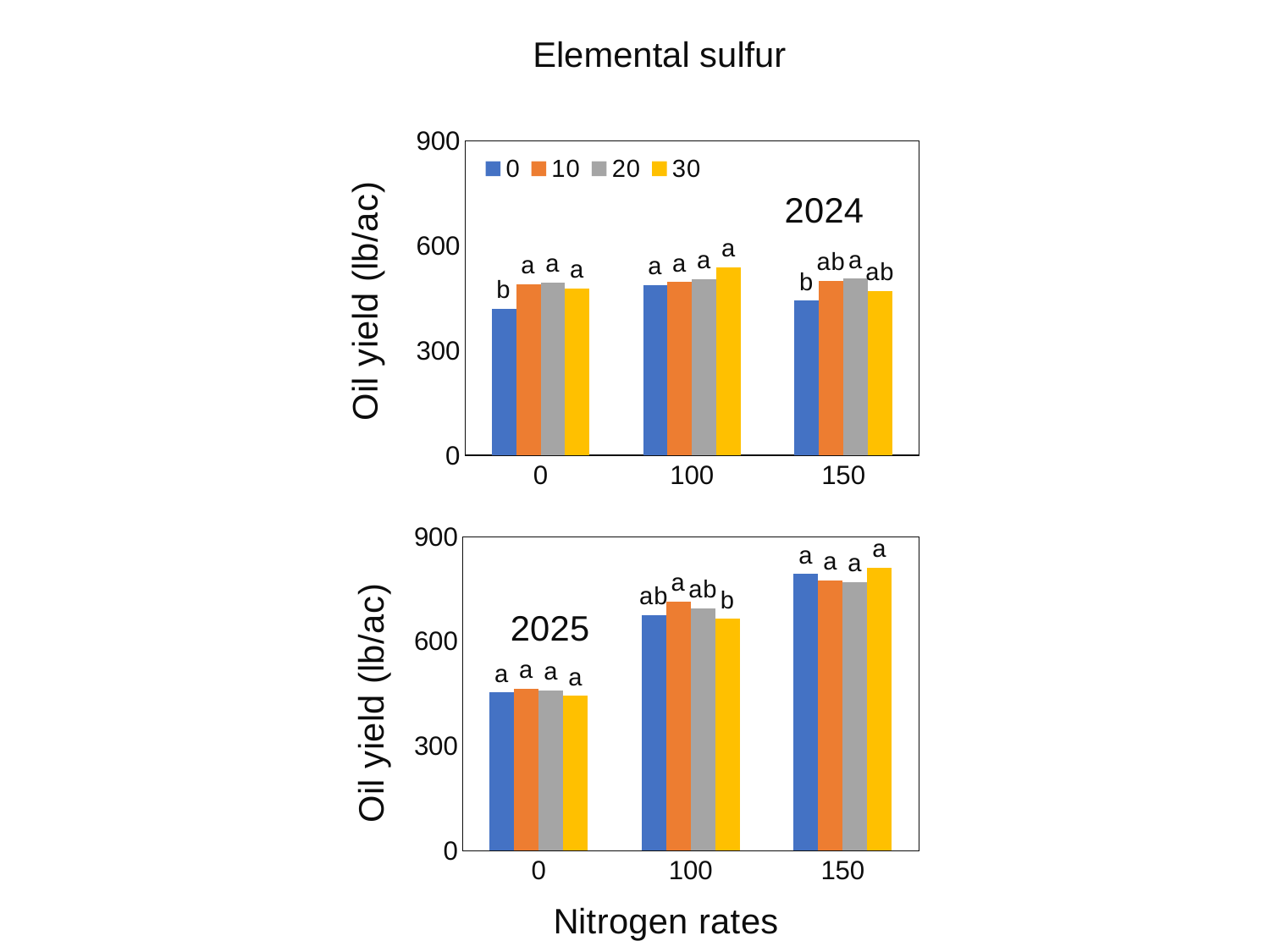
In the top (2024) chart, for series 30, which nitrogen rate has the highest oil yield? 100 In the top (2024) chart, at nitrogen rate 0, which is larger: series 0 or series 20? 20 In the bottom (2025) chart, at nitrogen rate 100, which is larger: series 10 or series 30? 10 In the bottom (2025) chart, does the oil yield for series 0 rise or fall as the nitrogen rate increases from 0 to 150? rise What is the title shown above the charts? Elemental sulfur How many series does the legend list in the top (2024) chart? 4 In the bottom (2025) chart, for series 30, which nitrogen rate has the highest oil yield? 150 In the bottom (2025) chart, is the value for series 30 at nitrogen rate 0 greater or less than 600? less How many nitrogen rate categories are shown on the x axis of the bottom (2025) chart? 3 What kind of chart is the top (2024) chart? bar chart In the top (2024) chart, is the value for series 0 at nitrogen rate 0 greater or less than 600? less In the bottom (2025) chart, is the value for series 30 at nitrogen rate 150 greater or less than 600? greater